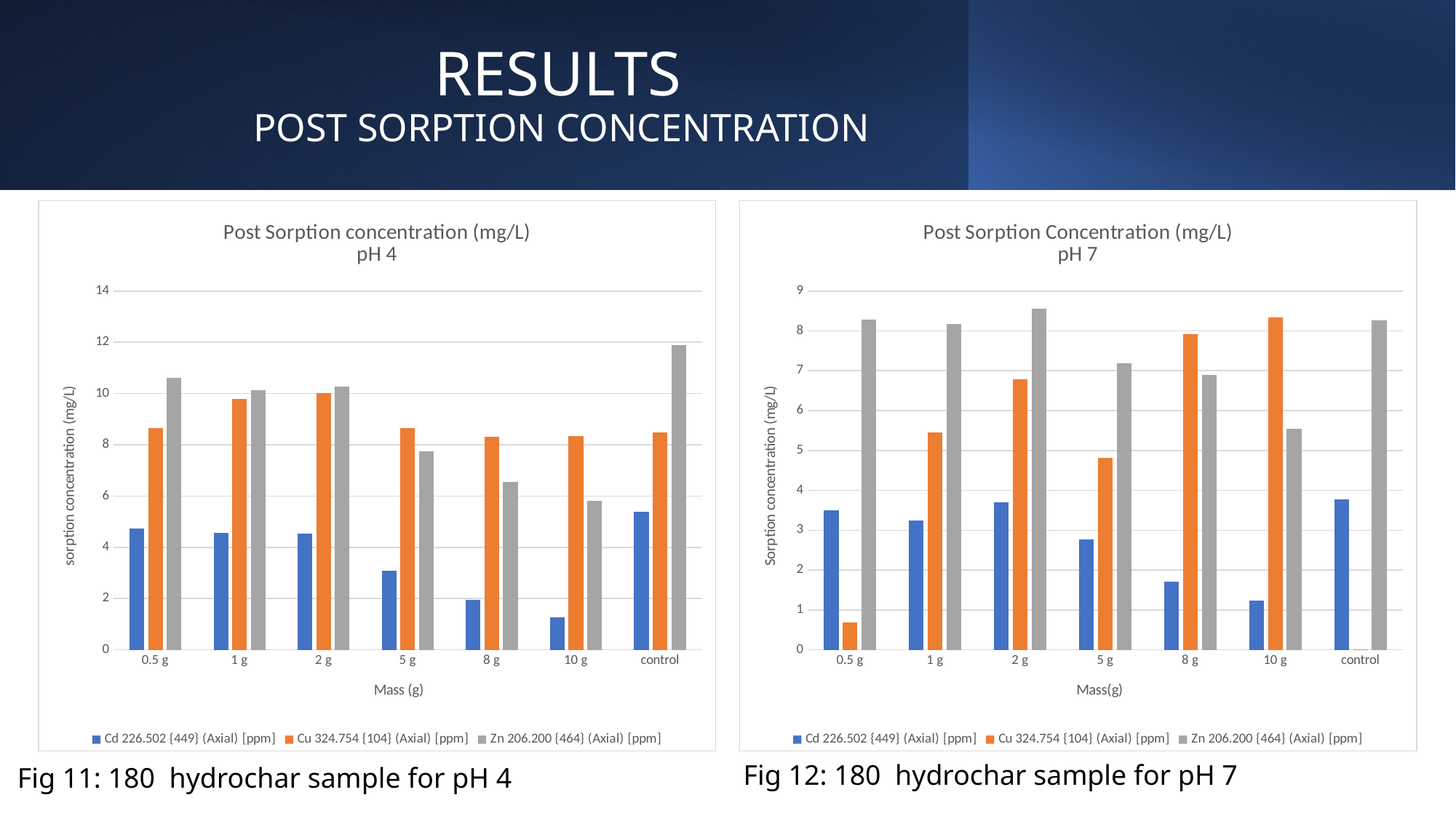
In the pH 4 chart on the left, which category has the highest Zn 206.200 bar? control How many mass categories are shown on the x axis of the pH 4 chart on the left? 7 In the pH 7 chart on the right, at 5 g, which is larger: the Cu 324.754 bar or the Zn 206.200 bar? Zn 206.200 In the pH 4 chart on the left, which category has the lowest Cd 226.502 bar? 10 g In the pH 4 chart on the left, is the Cd 226.502 value for 10 g greater or less than 2? less In the pH 7 chart on the right, is the Cu 324.754 value for 10 g greater or less than 8? greater What type of chart is the 'Post Sorption concentration (mg/L) pH 4' chart on the left? bar chart In the pH 4 chart on the left, is the Zn 206.200 value for 0.5 g greater or less than 10? greater In the pH 4 chart on the left, at 5 g, which is larger: the Cu 324.754 bar or the Zn 206.200 bar? Cu 324.754 How many series does the legend of the pH 7 chart on the right list? 3 In the pH 7 chart on the right, which category has the lowest Cu 324.754 bar? control In the pH 4 chart on the left, does the Cd 226.502 series rise or fall from 0.5 g to 10 g? fall